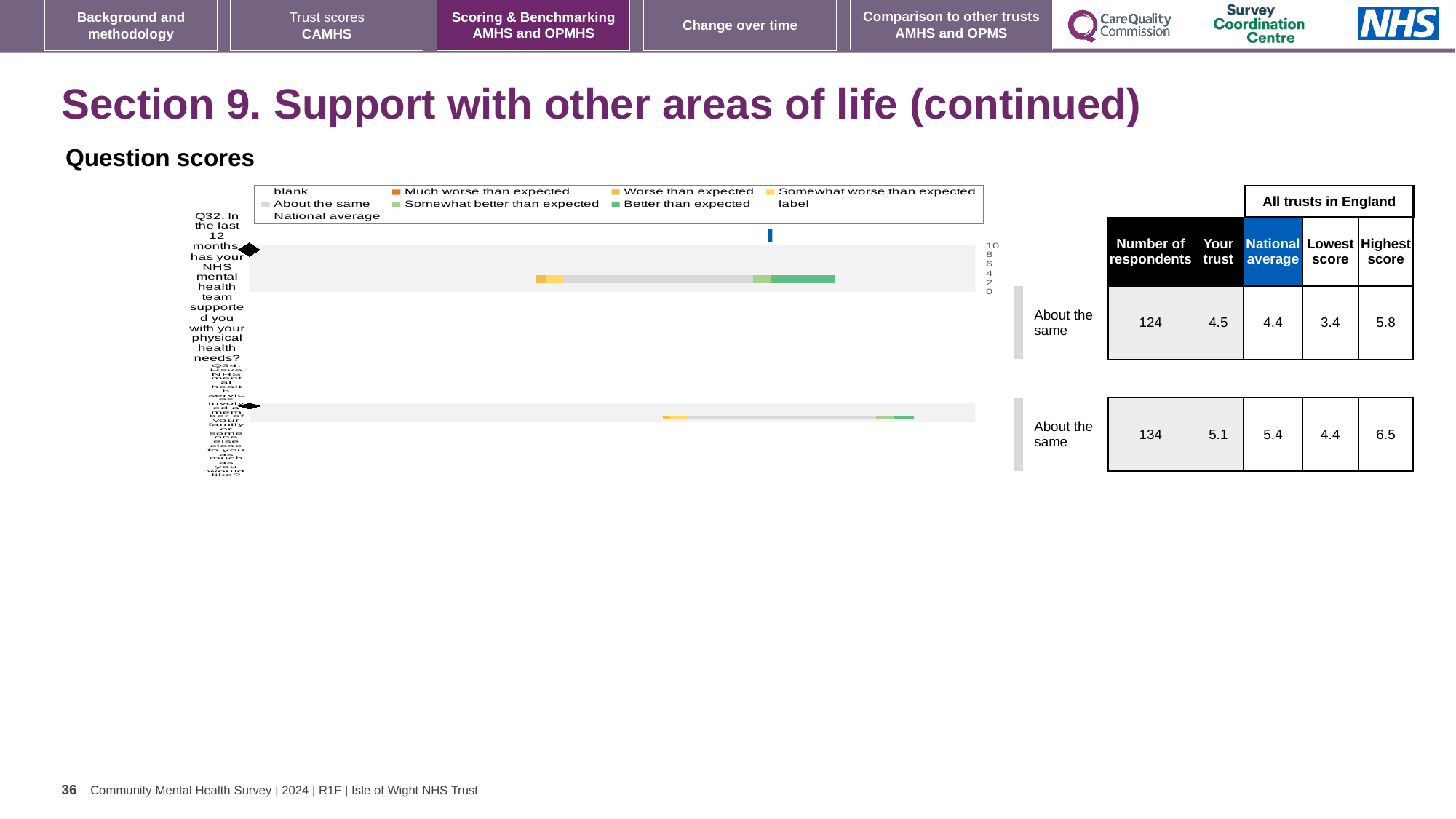
What is the difference between the highest score and the lowest score for Q34? 2.1 What colour represents 'Better than expected' in the chart legend? green What is the 'Your trust' score for Q32 (support with physical health needs)? 4.5 What is the national average score for Q32? 4.4 What kind of chart is shown on the slide? bar chart How many survey questions (rows) are plotted in the chart? 2 What is the difference between the highest score and the lowest score for Q32? 2.4 Which benchmark category is the trust placed in for Q32? About the same How many respondents answered Q34? 134 Which question had more respondents, Q32 or Q34? Q34 What is the 'Your trust' score for Q34 (involving family or someone close)? 5.1 What is the national average score for Q34? 5.4